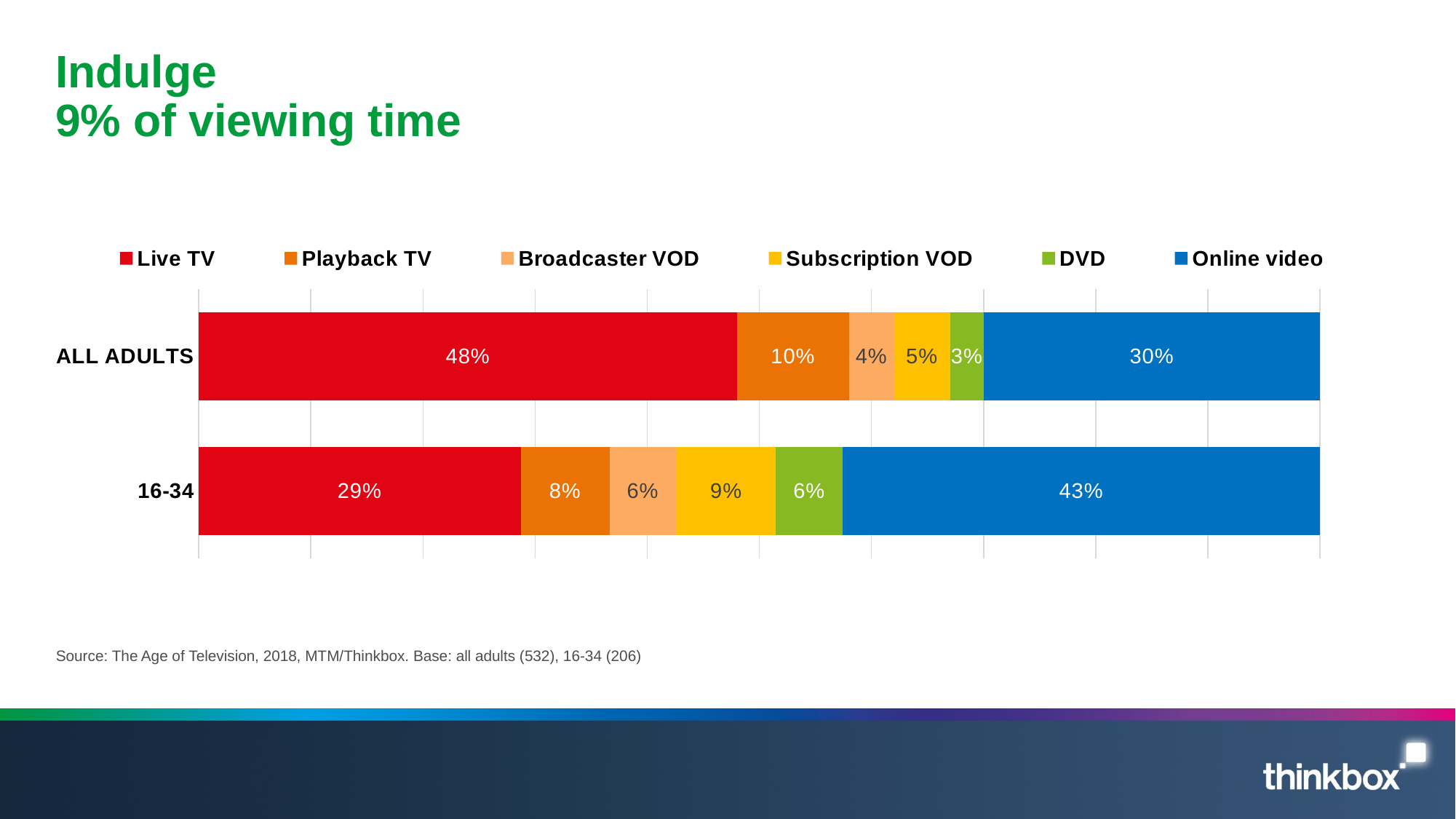
How many categories (groups) are shown on the chart? 2 What is the difference between the Live TV share for ALL ADULTS and for 16-34? 19 percentage points What is the Live TV share for ALL ADULTS? 48% What kind of chart is shown on the slide? Stacked horizontal bar chart How many series does the legend list? 6 What colour represents Online video in the chart? Blue What is the Online video share for the 16-34 group? 43% What is the DVD share for ALL ADULTS? 3% Which series has the smallest share for the 16-34 group? Broadcaster VOD and DVD (6% each) Which series has the largest share for ALL ADULTS? Live TV Which group has the larger Online video share, ALL ADULTS or 16-34? 16-34 What is the Subscription VOD share for the 16-34 group? 9%